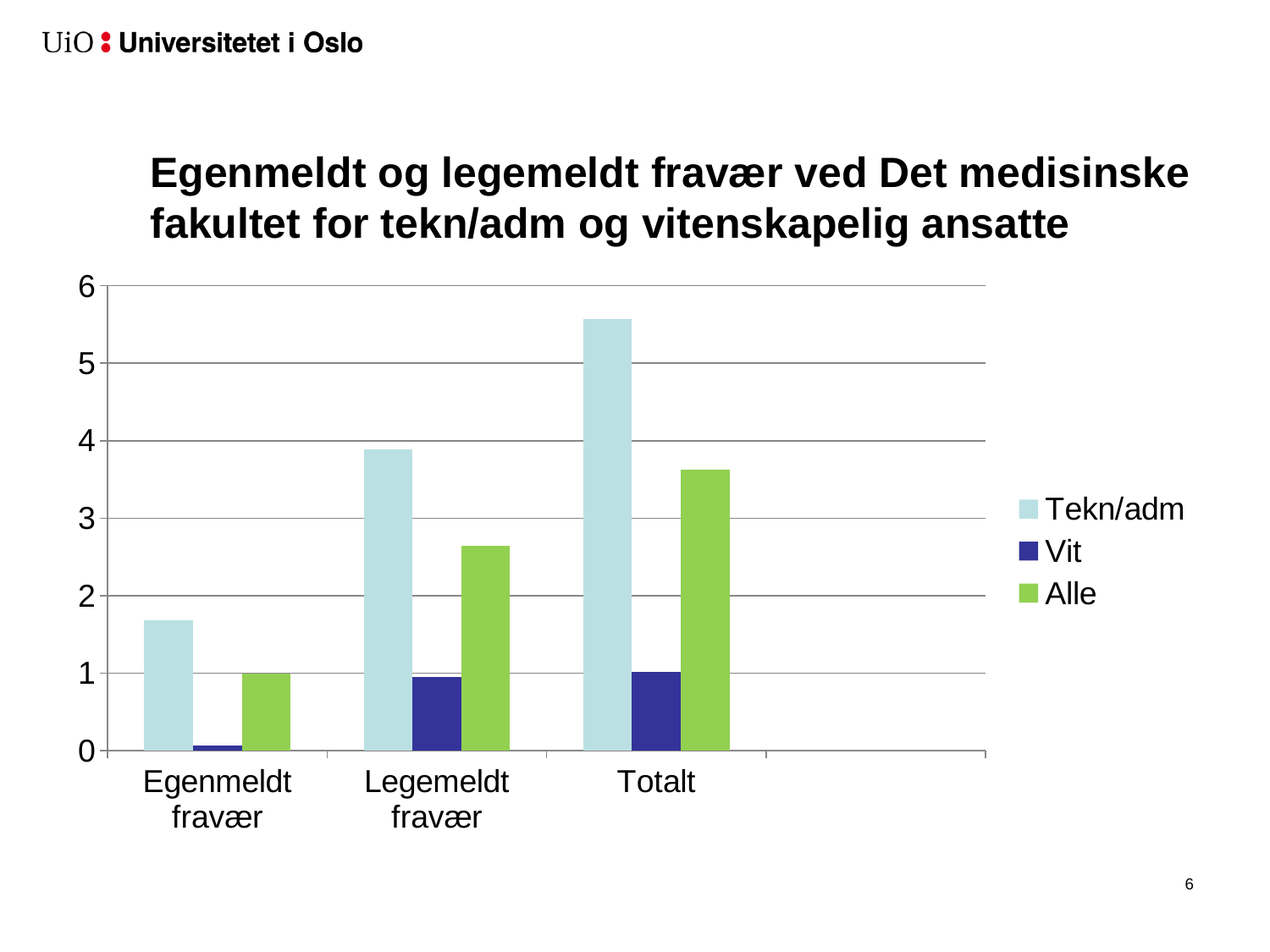
Is the Tekn/adm value for Legemeldt fravær greater or less than 4? less Which series is shown in green in the legend? Alle What kind of chart is shown on the slide? bar chart Which is larger for Legemeldt fravær: the Tekn/adm value or the Alle value? Tekn/adm How many categories are shown on the x axis? 3 Do the Tekn/adm values rise or fall from Egenmeldt fravær to Totalt? rise Which series has the highest value for Totalt? Tekn/adm Which category has the highest Tekn/adm value? Totalt Is the Alle value for Legemeldt fravær greater or less than 3? less Is the Tekn/adm value for Totalt greater or less than 5? greater Which series has the lowest value for Egenmeldt fravær? Vit How many series does the legend list? 3